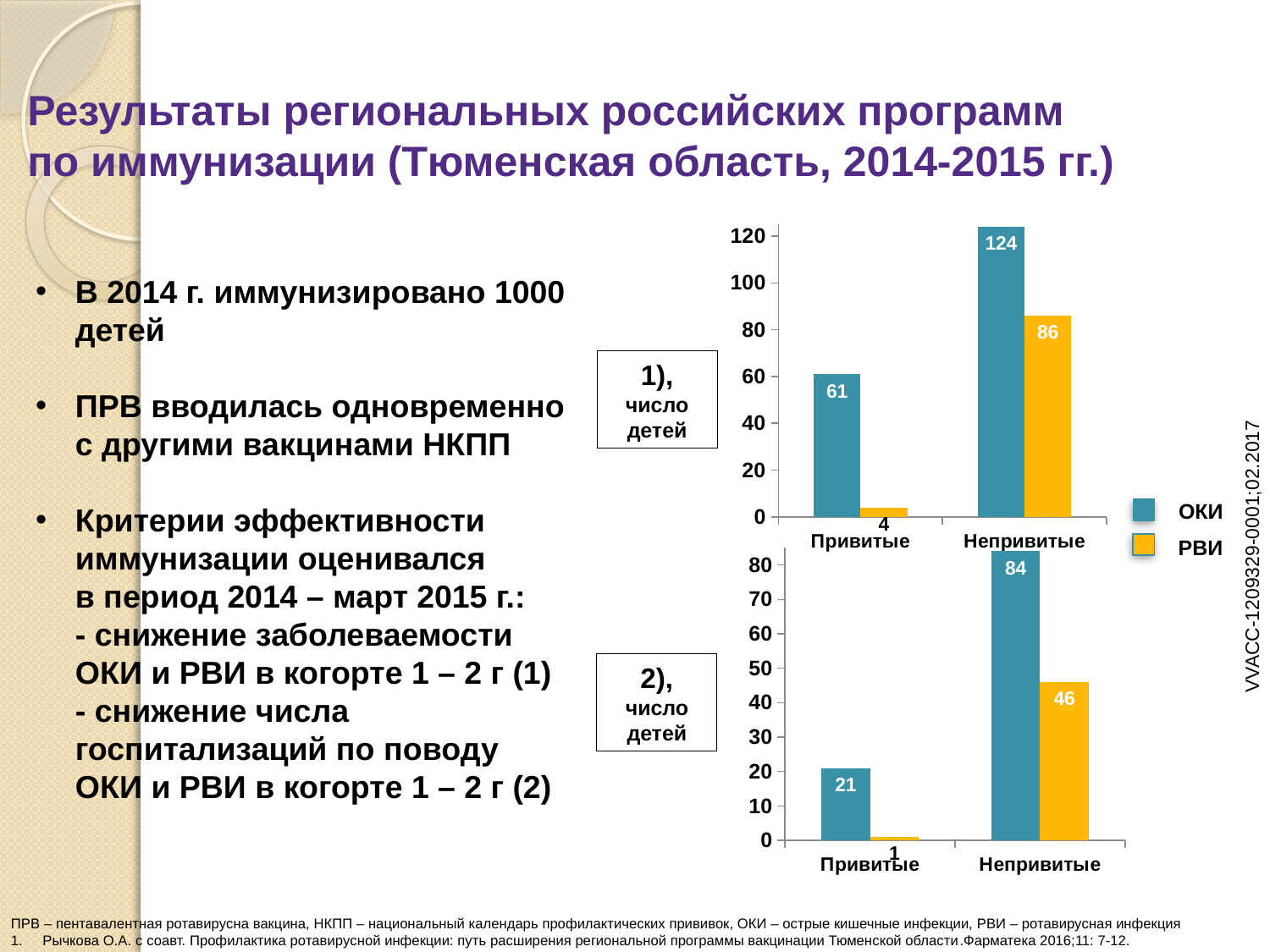
In the bottom chart (2), what is the value of ОКИ for Привитые? 21 How many series does the legend list? 2 In the top chart (1), which bar is the highest? ОКИ for Непривитые In the top chart (1), what is the value of РВИ for Привитые? 4 In the bottom chart (2), what is the difference between ОКИ for Непривитые and ОКИ for Привитые? 63 What type of chart is the bottom chart (2)? Bar chart In the top chart (1), what is the value of ОКИ for Непривитые? 124 In the top chart (1), which is larger: ОКИ for Привитые or РВИ for Непривитые? РВИ for Непривитые Which colour represents РВИ in the legend? Orange In the bottom chart (2), what is the value of РВИ for Непривитые? 46 In the bottom chart (2), which bar is the lowest? РВИ for Привитые In the top chart (1), what is the difference between ОКИ and РВИ for Непривитые? 38